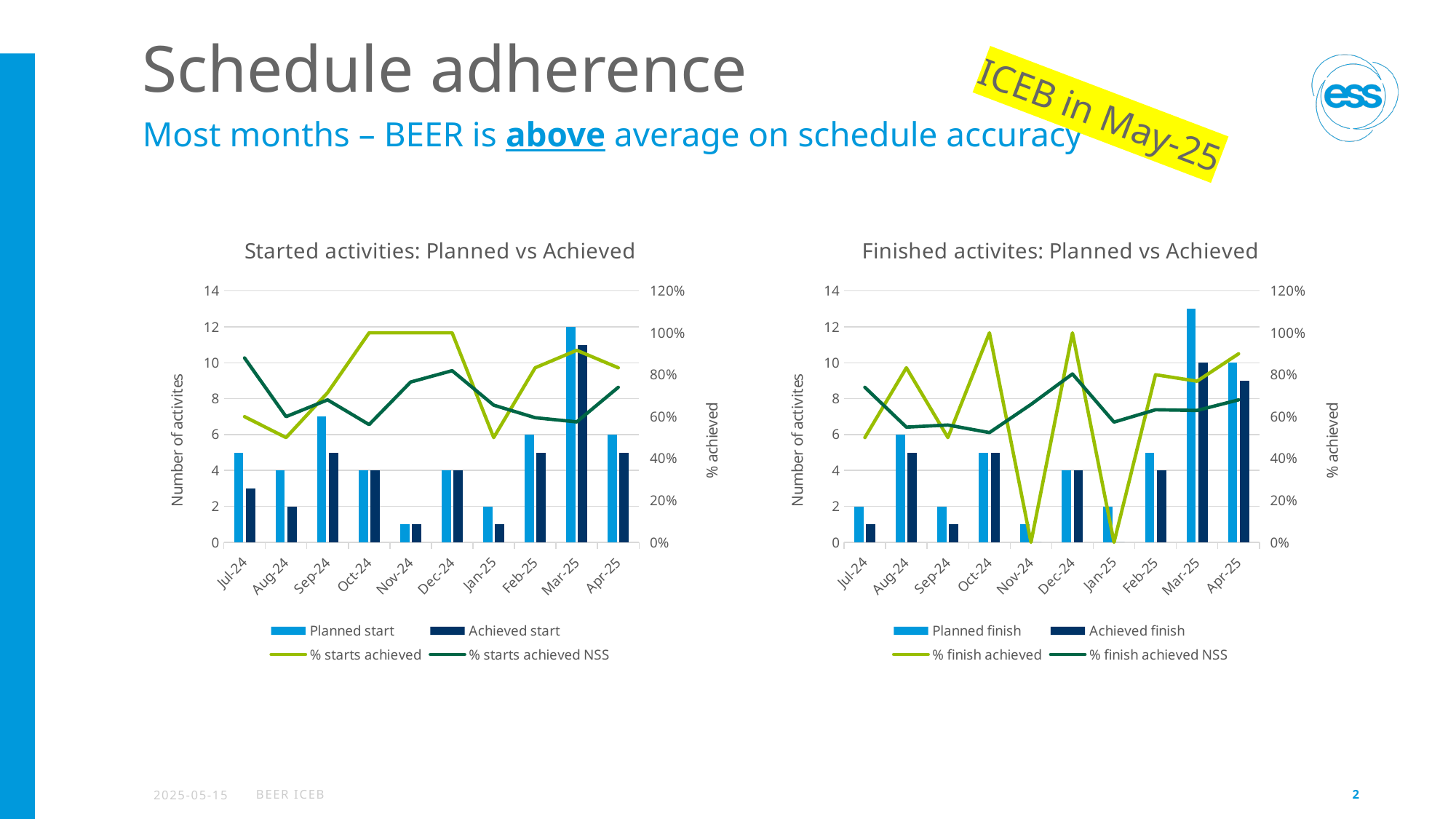
On the 'Finished activites: Planned vs Achieved' chart, what is the Achieved finish value for Mar-25? 10 On the 'Finished activites: Planned vs Achieved' chart, is the '% finish achieved' value for Nov-24 greater or less than 20%? less How many months are shown on the x axis of the 'Started activities: Planned vs Achieved' chart? 10 On the 'Started activities: Planned vs Achieved' chart, what is the Planned start value for Aug-24? 4 On the 'Started activities: Planned vs Achieved' chart, which month has the highest Planned start value? Mar-25 On the 'Finished activites: Planned vs Achieved' chart, what is the Planned finish value for Aug-24? 6 On the 'Finished activites: Planned vs Achieved' chart, which month has the larger Planned finish value, Mar-25 or Apr-25? Mar-25 How many series does the legend of the 'Finished activites: Planned vs Achieved' chart list? 4 On the 'Finished activites: Planned vs Achieved' chart, which month has the lowest Planned finish value? Nov-24 On the 'Started activities: Planned vs Achieved' chart, what is the Planned start value for Mar-25? 12 On the 'Started activities: Planned vs Achieved' chart, is the '% starts achieved' value for Oct-24 greater or less than 80%? greater On the 'Started activities: Planned vs Achieved' chart, what is the difference between the Planned start values for Mar-25 and Apr-25? 6